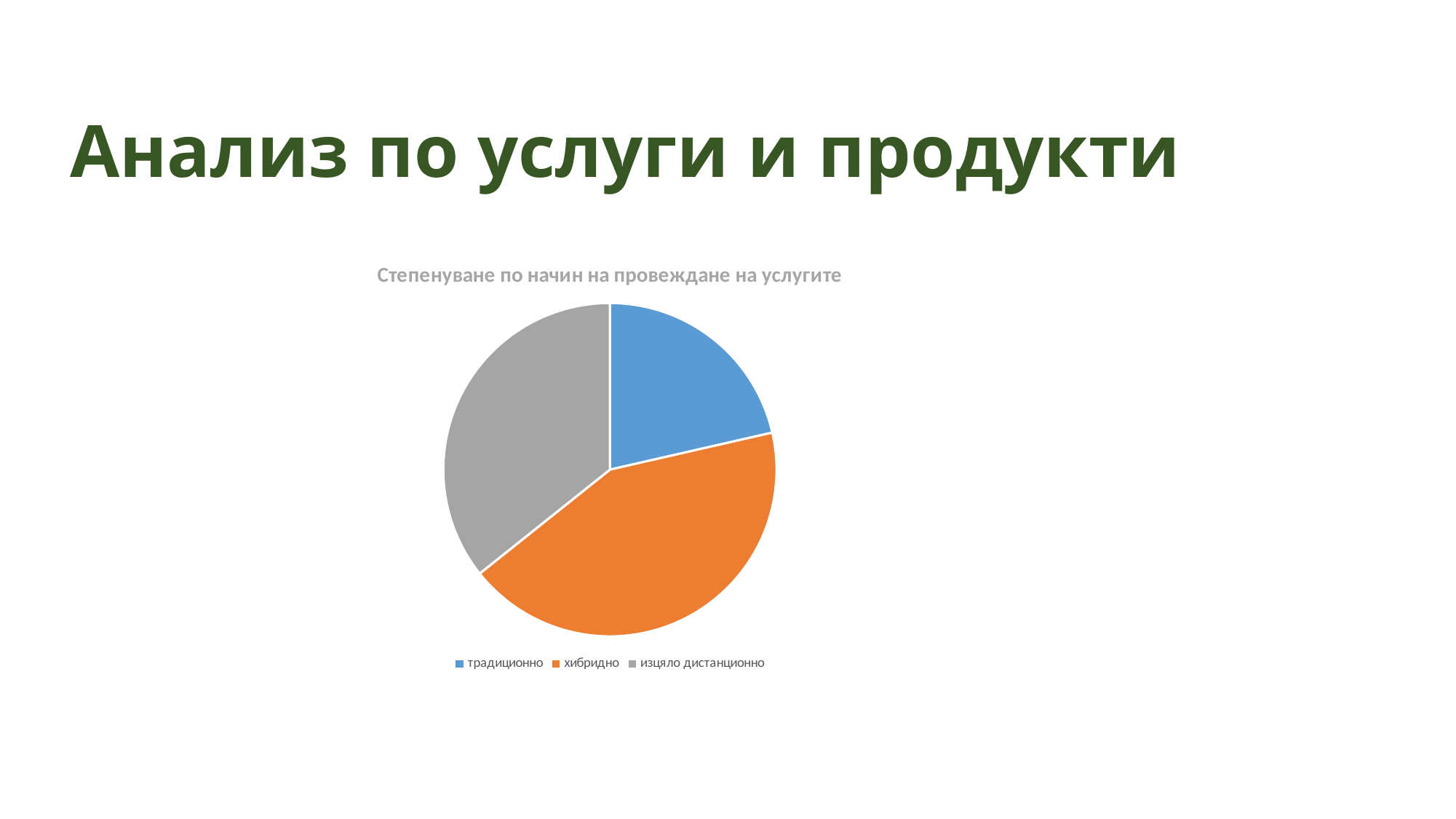
How many entries does the legend list? 3 Which slice is larger, хибридно or традиционно? хибридно Which slice is larger, изцяло дистанционно or традиционно? изцяло дистанционно Which category has the smallest slice of the pie? традиционно How many slices does the pie chart have? 3 What is the title of the chart? Степенуване по начин на провеждане на услугите Which category has the largest slice of the pie? хибридно What colour is the slice for хибридно? orange What kind of chart is shown on the slide? pie chart